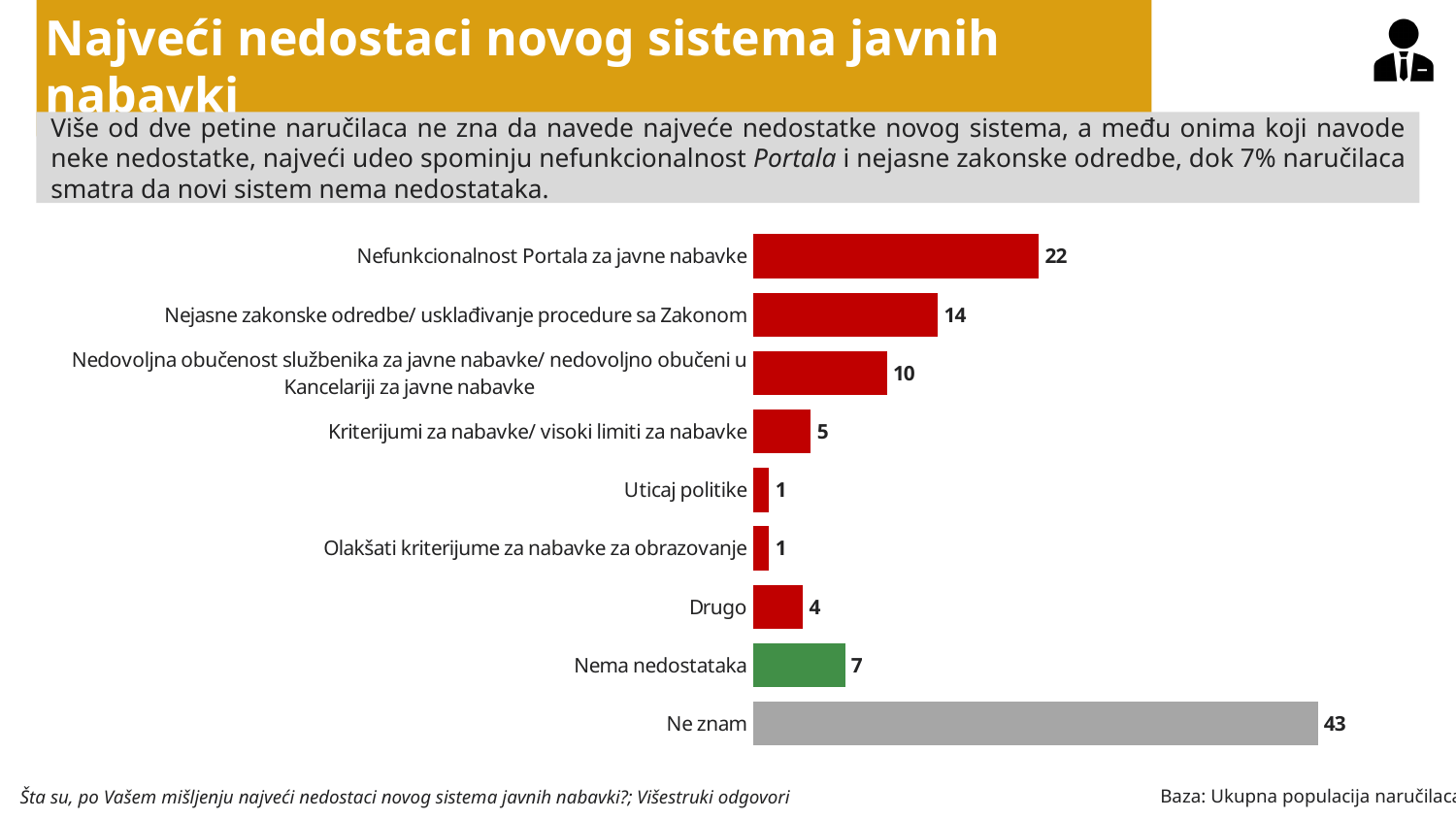
What is the difference between "Nefunkcionalnost Portala za javne nabavke" and "Nejasne zakonske odredbe/ usklađivanje procedure sa Zakonom"? 8 What colour is the bar for "Nema nedostataka"? Green What is the difference between "Ne znam" and "Nefunkcionalnost Portala za javne nabavke"? 21 Which is larger: "Drugo" or "Nema nedostataka"? Nema nedostataka What is the value for "Nefunkcionalnost Portala za javne nabavke"? 22 What is the value for "Ne znam"? 43 What is the value for "Uticaj politike"? 1 What is the value for "Kriterijumi za nabavke/ visoki limiti za nabavke"? 5 How many categories are shown in the chart? 9 What kind of chart is shown on the slide? Bar chart Which category has the highest value? Ne znam What is the value for "Nema nedostataka"? 7